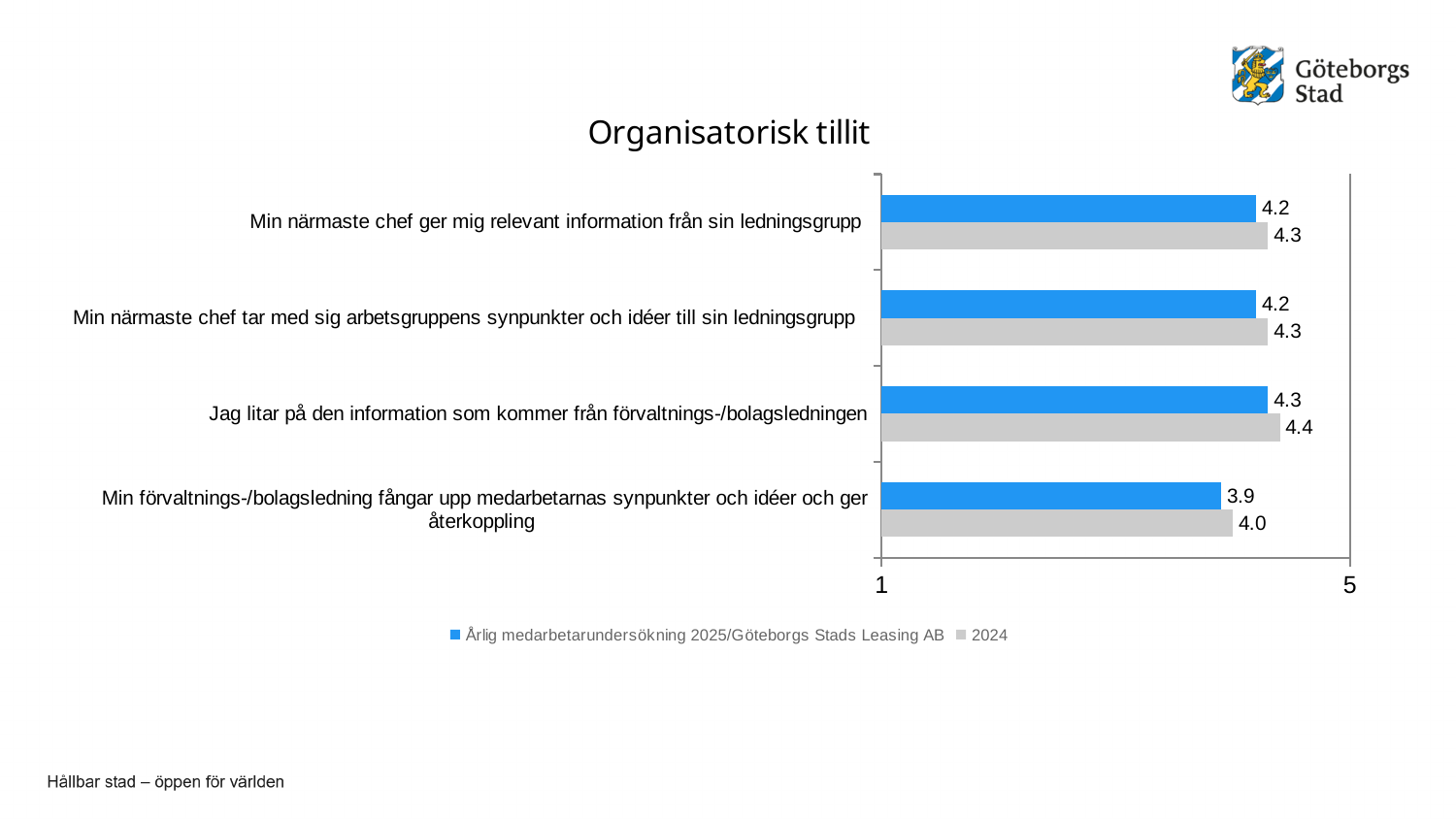
What is the 2024 value for "Min närmaste chef tar med sig arbetsgruppens synpunkter och idéer till sin ledningsgrupp"? 4.3 What is the 2025 value for "Min förvaltnings-/bolagsledning fångar upp medarbetarnas synpunkter och idéer och ger återkoppling"? 3.9 What is the difference between the 2024 and 2025 values for "Min förvaltnings-/bolagsledning fångar upp medarbetarnas synpunkter och idéer och ger återkoppling"? 0.1 How many series does the legend list? 2 What is the 2025 (Årlig medarbetarundersökning 2025/Göteborgs Stads Leasing AB) value for "Min närmaste chef ger mig relevant information från sin ledningsgrupp"? 4.2 Which category has the highest 2024 value? Jag litar på den information som kommer från förvaltnings-/bolagsledningen What is the 2024 value for "Jag litar på den information som kommer från förvaltnings-/bolagsledningen"? 4.4 What kind of chart is shown on the slide? Bar chart Which category has the lowest 2025 value? Min förvaltnings-/bolagsledning fångar upp medarbetarnas synpunkter och idéer och ger återkoppling How many categories are shown in the chart? 4 What is the title of the chart? Organisatorisk tillit For "Jag litar på den information som kommer från förvaltnings-/bolagsledningen", which is larger: the 2025 value or the 2024 value? 2024